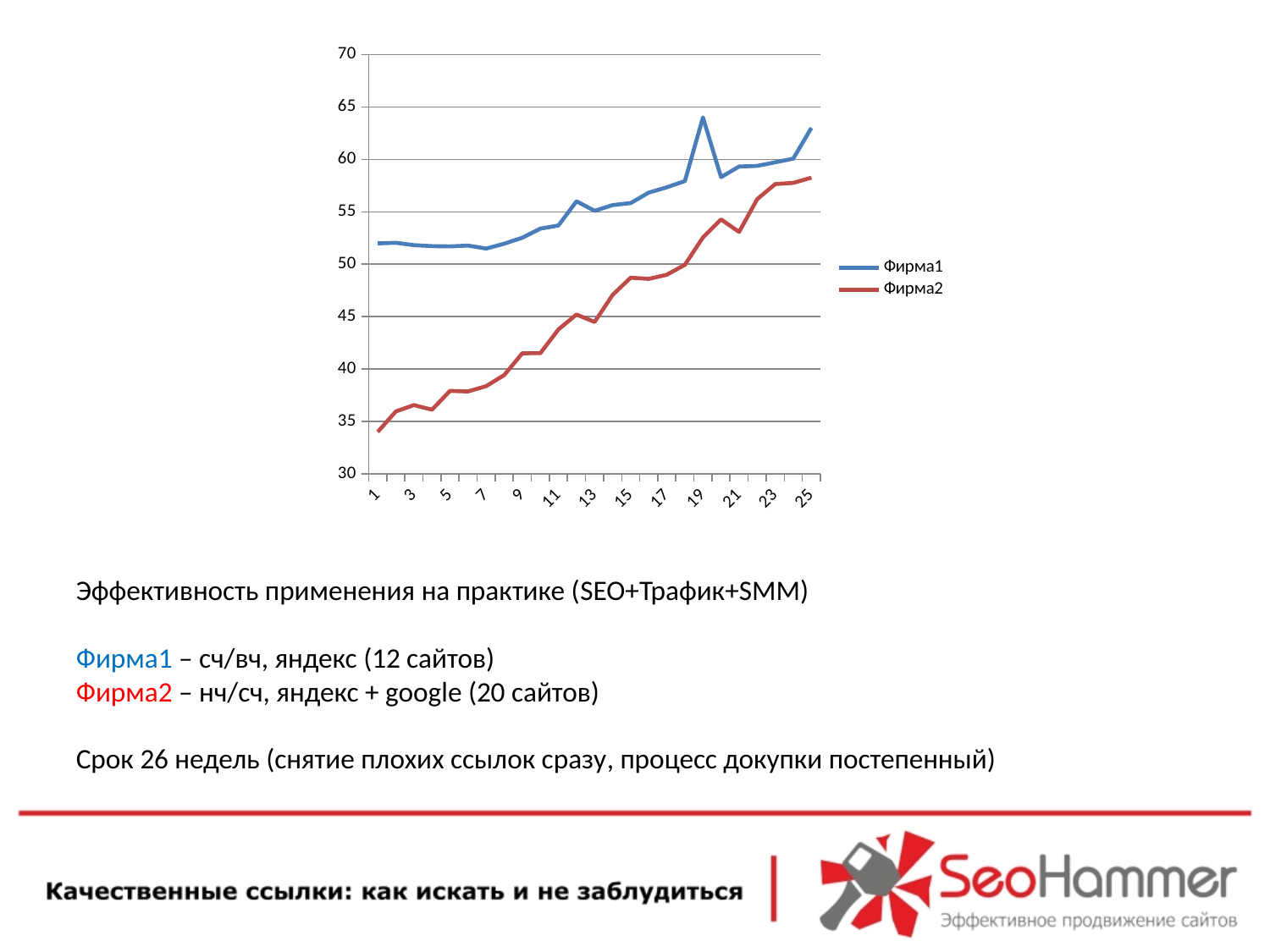
At x = 1, which series has the larger value, Фирма1 or Фирма2? Фирма1 Is the value for Фирма2 at x = 25 greater or less than 55? greater Is the value for Фирма1 at x = 19 greater or less than 60? greater Is the value for Фирма2 at x = 13 greater or less than 50? less Does the value for Фирма1 rise or fall along the x axis overall? rise What kind of chart is shown on the slide? line chart How many series does the legend list? 2 What colour is the line for Фирма2? red What are the two series named in the legend? Фирма1 and Фирма2 At x = 25, which series has the larger value, Фирма1 or Фирма2? Фирма1 Does the value for Фирма2 rise or fall along the x axis overall? rise